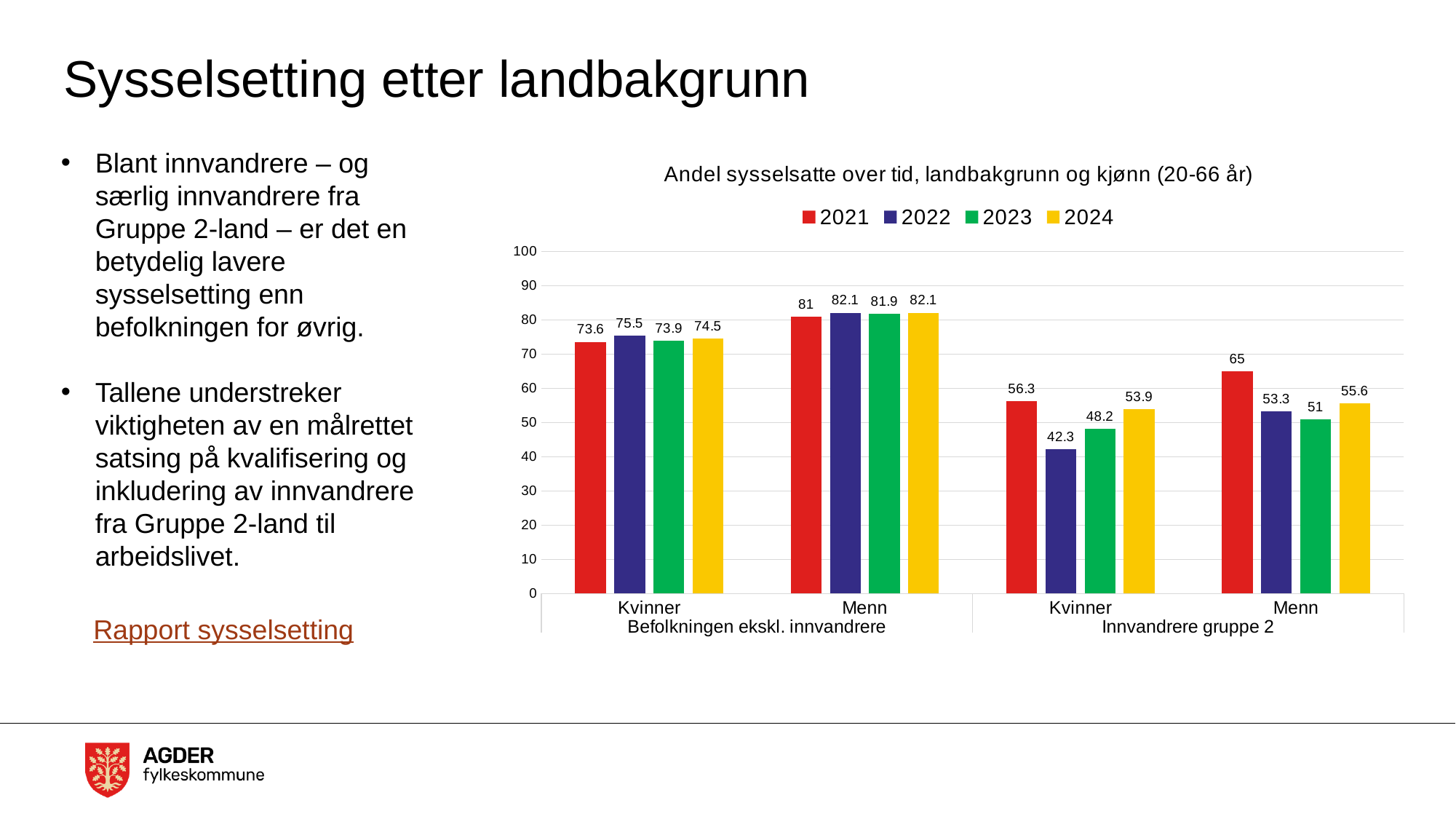
Do the values for Kvinner in the Innvandrere gruppe 2 group rise or fall from 2022 to 2024? Rise What is the title of the chart? Andel sysselsatte over tid, landbakgrunn og kjønn (20-66 år) What kind of chart is shown on the slide? Bar chart Which year has the lowest value for Kvinner in the Innvandrere gruppe 2 group? 2022 How many series does the legend list? 4 What is the 2024 value for Kvinner in the Befolkningen ekskl. innvandrere group? 74.5 Which is larger: the 2024 value for Kvinner in Innvandrere gruppe 2 or the 2024 value for Menn in Innvandrere gruppe 2? Menn in Innvandrere gruppe 2 What is the 2023 value for Menn in the Befolkningen ekskl. innvandrere group? 81.9 What is the 2022 value for Kvinner in the Innvandrere gruppe 2 group? 42.3 What is the difference between the 2021 and 2022 values for Menn in the Innvandrere gruppe 2 group? 11.7 Which year has the highest value for Menn in the Innvandrere gruppe 2 group? 2021 What is the 2021 value for Menn in the Innvandrere gruppe 2 group? 65